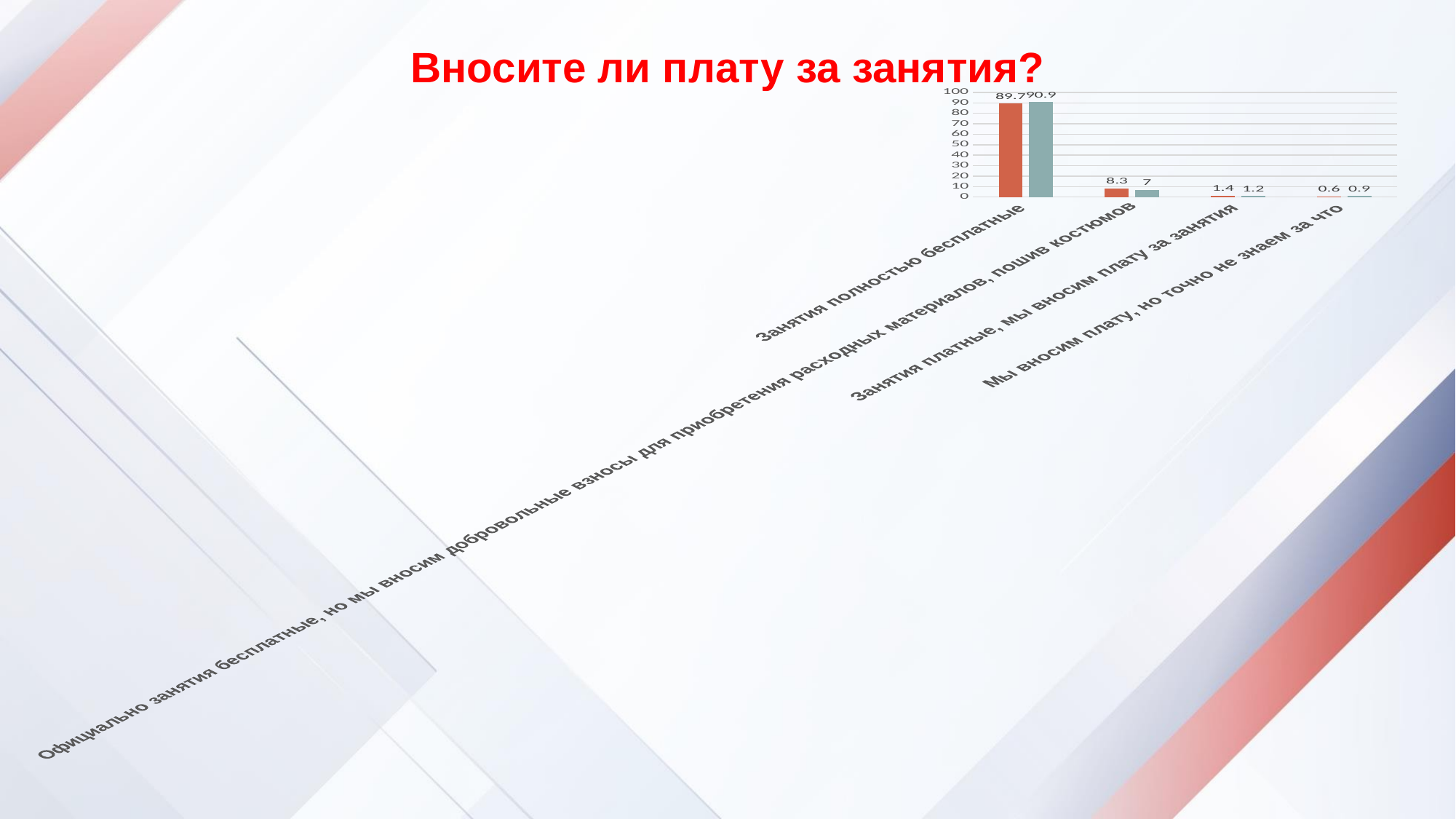
What is the title of the chart on the slide? Вносите ли плату за занятия? What is the value of the teal bar for "Занятия полностью бесплатные"? 90.9 For "Занятия полностью бесплатные", which bar is larger, the red or the teal one? teal Is the red bar for "Занятия полностью бесплатные" greater or less than 80? greater What is the value of the red bar for "Занятия платные, мы вносим плату за занятия"? 1.4 What is the value of the teal bar for "Мы вносим плату, но точно не знаем за что"? 0.9 What is the value of the red bar for "Занятия полностью бесплатные"? 89.7 How many categories does the chart show? 4 Which category has the lowest values in the chart? Мы вносим плату, но точно не знаем за что What is the difference between the red and teal bars for "Официально занятия бесплатные, но мы вносим добровольные взносы для приобретения расходных материалов, пошив костюмов"? 1.3 What kind of chart is shown on the slide? bar chart Which category has the highest values in the chart? Занятия полностью бесплатные